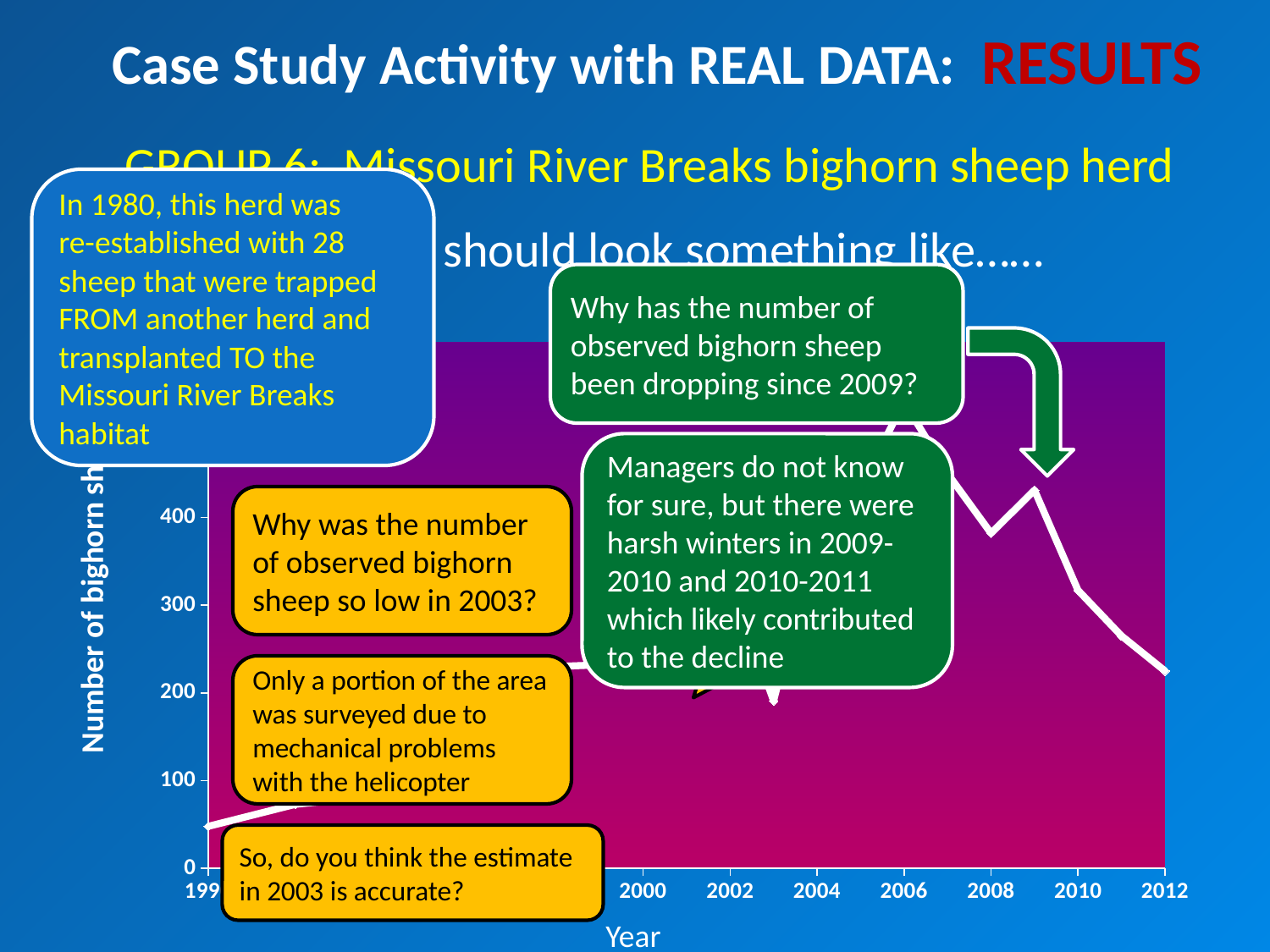
Which year has the larger value, 2008 or 2012? 2008 Do the values rise or fall between 2009 and 2012? fall What kind of chart is shown on the slide? line chart Do the values rise or fall between 2008 and 2009? rise Is the value for 2009 greater or less than 400? greater What is the label of the x axis of the chart? Year Is the value for 2012 greater or less than 300? less Which year has the larger value, 2009 or 2012? 2009 Is the value for 2012 greater or less than 100? greater